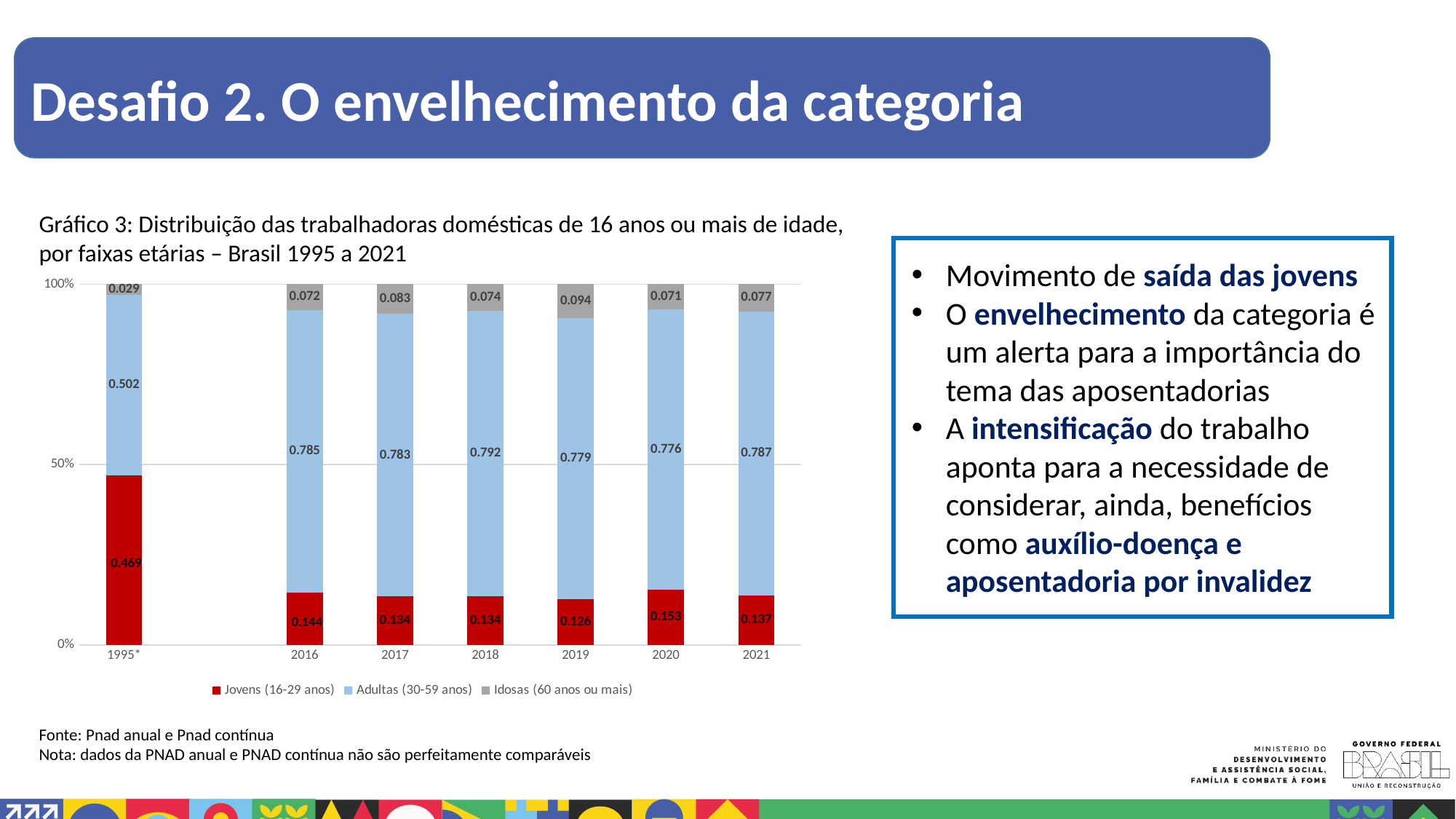
What is the value for Jovens (16-29 anos) in 1995*? 0.469 How many series does the legend list? 3 Does the share of Jovens (16-29 anos) rise or fall from 1995* to 2021? Fall What is the difference between the Jovens (16-29 anos) value in 1995* and in 2021? 0.332 Which year has the highest value for Jovens (16-29 anos)? 1995* What kind of chart is shown? Stacked bar chart Which year has the lowest value for Jovens (16-29 anos)? 2019 Which year has the larger value for Idosas (60 anos ou mais), 2017 or 2018? 2017 What is the value for Adultas (30-59 anos) in 2018? 0.792 What is the value for Idosas (60 anos ou mais) in 2019? 0.094 How many years are shown on the x axis? 7 Which year has the lowest value for Idosas (60 anos ou mais)? 1995*